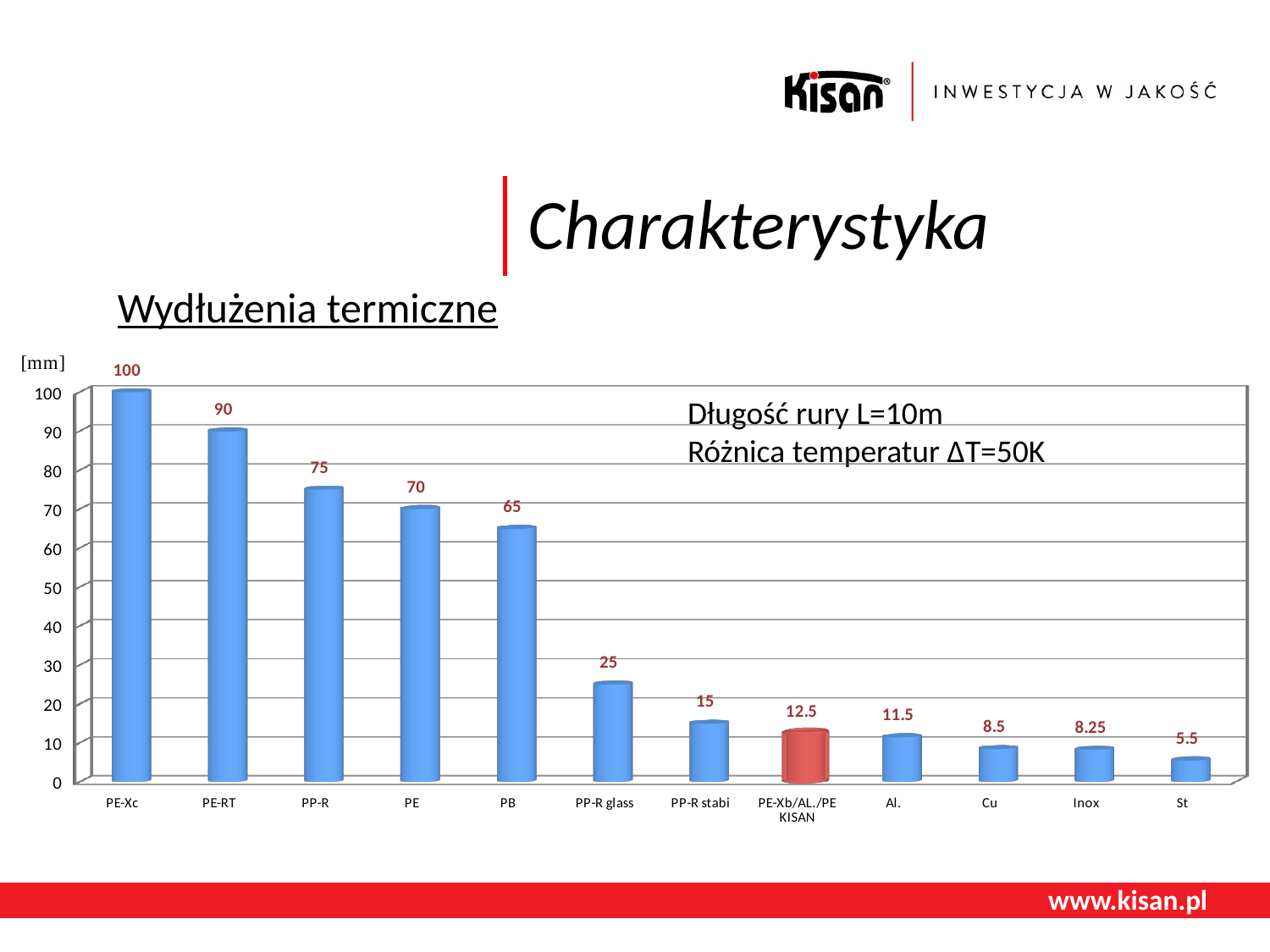
Which category has the highest value? PE-Xc What is the value for PE-Xc? 100 What kind of chart is shown on the slide? bar chart What is the value for Inox? 8.25 Which is larger, the value for PP-R glass or the value for PP-R stabi? PP-R glass What is the value for PE-Xb/AL./PE KISAN? 12.5 Is the value for PB greater or less than 60? greater What is the difference between the values for Cu and St? 3 How many categories are shown on the x axis? 12 What is the difference between the values for PE-RT and PP-R? 15 Which category has the lowest value? St Do the values rise or fall from left to right along the x axis? fall